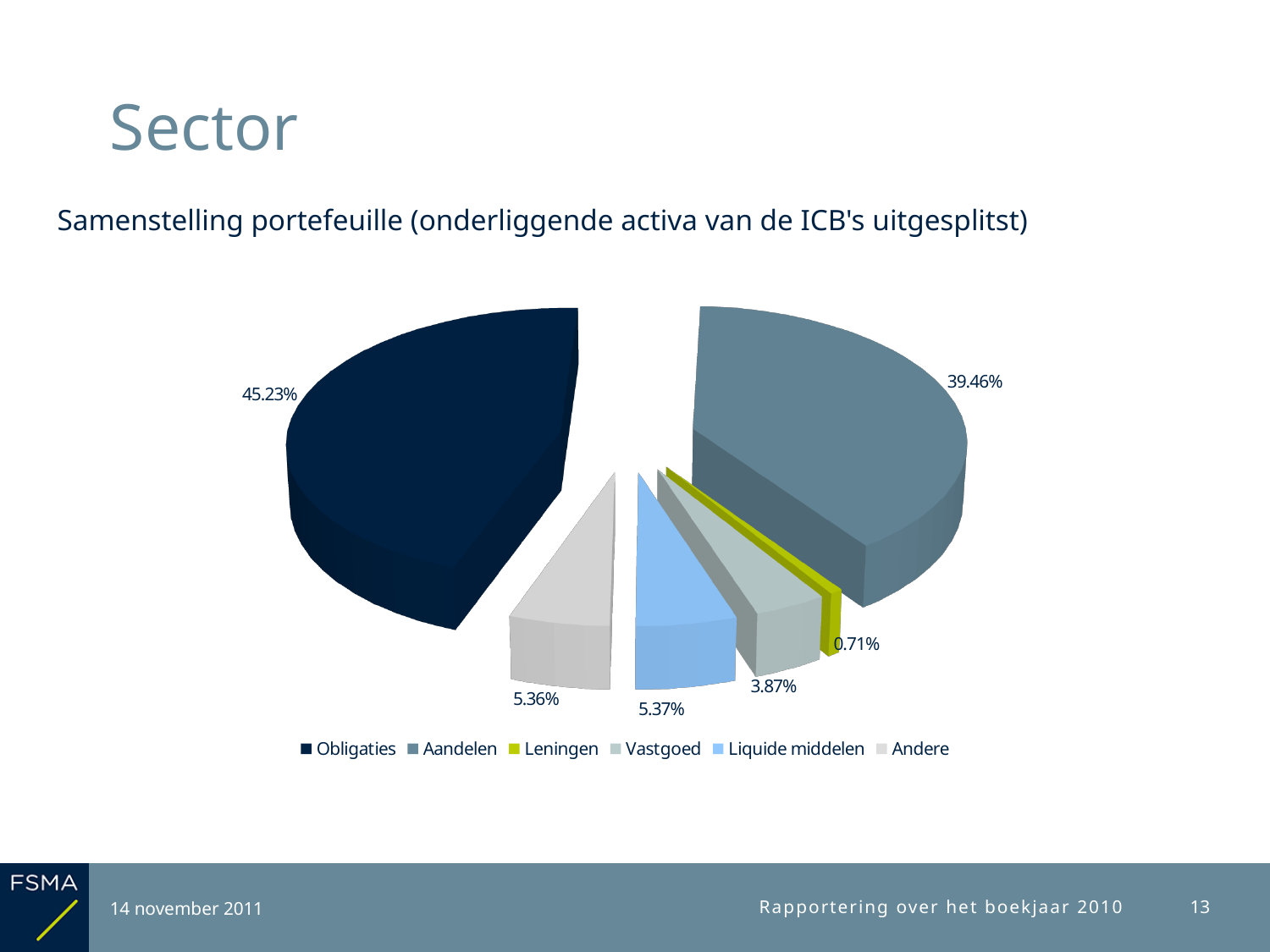
What share of the portfolio is Obligaties? 45.23% Which category has the largest slice of the pie? Obligaties Which is larger, the share for Vastgoed or the share for Andere? Andere What share of the portfolio is Liquide middelen? 5.37% How many slices does the pie chart have? 6 What share of the portfolio is Vastgoed? 3.87% What kind of chart is shown on the slide? pie chart What share of the portfolio is Aandelen? 39.46% What is the subtitle above the chart? Samenstelling portefeuille (onderliggende activa van de ICB's uitgesplitst) What is the difference in percentage points between Obligaties and Aandelen? 5.77 Which category has the smallest slice of the pie? Leningen What share of the portfolio is Leningen? 0.71%